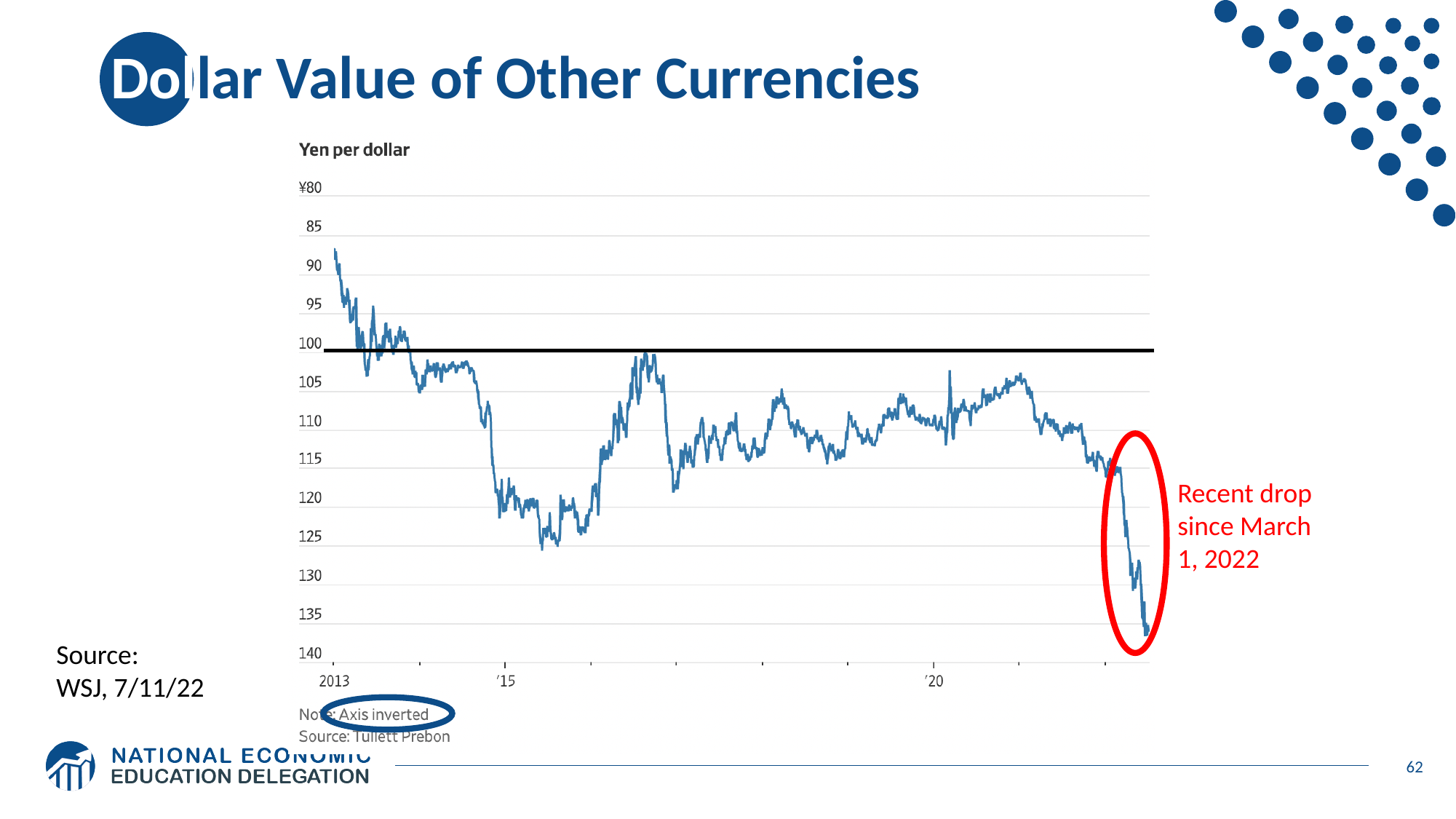
How many data series are plotted on the chart? 1 What quantity does the y axis of the chart measure, according to its label? Yen per dollar What kind of chart is shown on the slide? Line chart At which y-axis value is the thick black horizontal line drawn across the chart? 100 Is the yen-per-dollar value at the right-hand end of the line (mid-2022) greater or less than 130? greater Is the yen-per-dollar value at the '15 tick mark greater or less than 110? greater What is the first year labelled on the x axis of the chart? 2013 Does the yen-per-dollar value rise or fall over the period circled in red (since March 1, 2022)? rise Is the yen-per-dollar value at the start of the line in 2013 greater or less than 100? less What does the note beneath the chart say about the axis? Axis inverted Comparing the start of the line in 2013 with its end in 2022, does the yen-per-dollar value rise or fall? rise